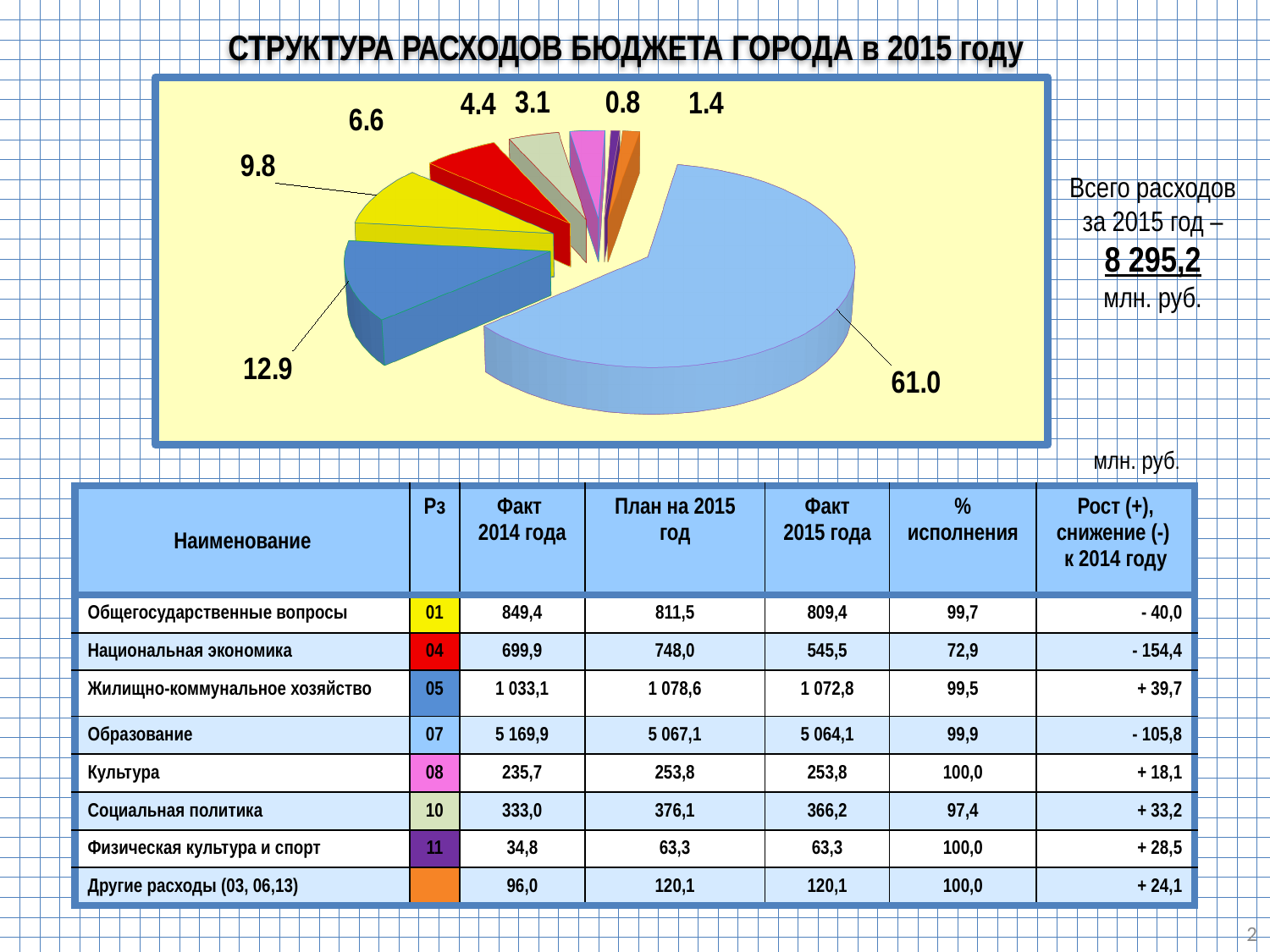
What is the difference between the largest slice (61.0) and the dark blue slice (12.9)? 48.1 What is the value of the largest slice of the pie chart? 61.0 Which slice is larger, the one labelled 4.4 or the one labelled 3.1? 4.4 What value is labelled on the dark blue slice of the pie chart? 12.9 What total expenditure for 2015 is stated next to the pie chart? 8 295,2 млн. руб. What is the difference between the yellow slice (9.8) and the red slice (6.6)? 3.2 What kind of chart is shown on the slide? pie chart What is the value of the smallest slice of the pie chart? 0.8 What value is labelled on the orange slice of the pie chart? 1.4 What value is labelled on the red slice of the pie chart? 6.6 How many slices does the pie chart have? 8 What value is labelled on the yellow slice of the pie chart? 9.8